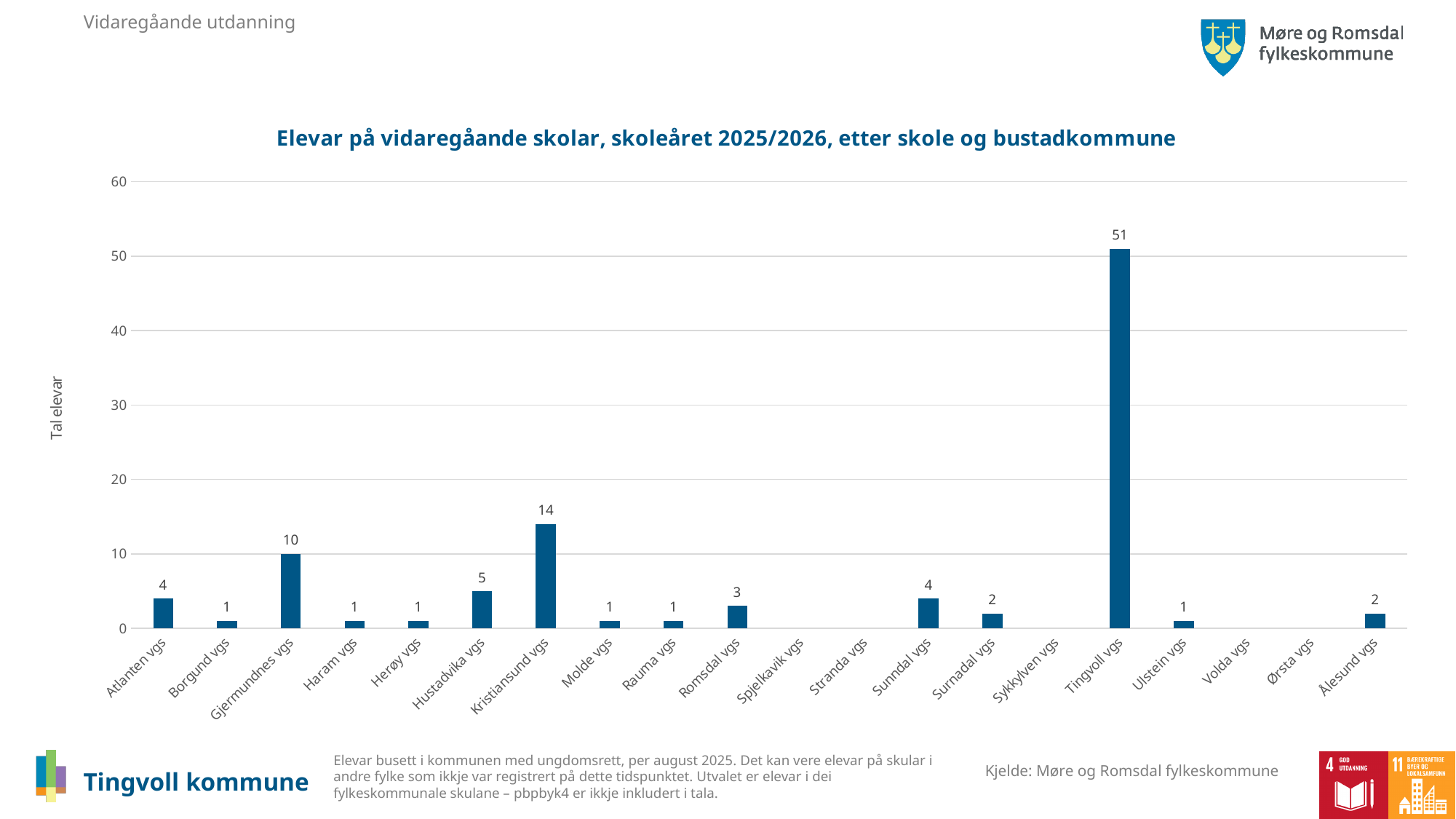
Is the value for Tingvoll vgs greater or less than 50? greater What is the label of the y axis? Tal elevar What is the value for Gjermundnes vgs? 10 Which school has the highest number of students? Tingvoll vgs How many students are shown for Tingvoll vgs? 51 How many schools are listed on the x axis? 20 Which is larger, the value for Gjermundnes vgs or Hustadvika vgs? Gjermundnes vgs What kind of chart is shown on the slide? Bar chart What is the difference between the values for Kristiansund vgs and Gjermundnes vgs? 4 What is the difference between the values for Tingvoll vgs and Kristiansund vgs? 37 What is the value for Romsdal vgs? 3 What is the value for Kristiansund vgs? 14